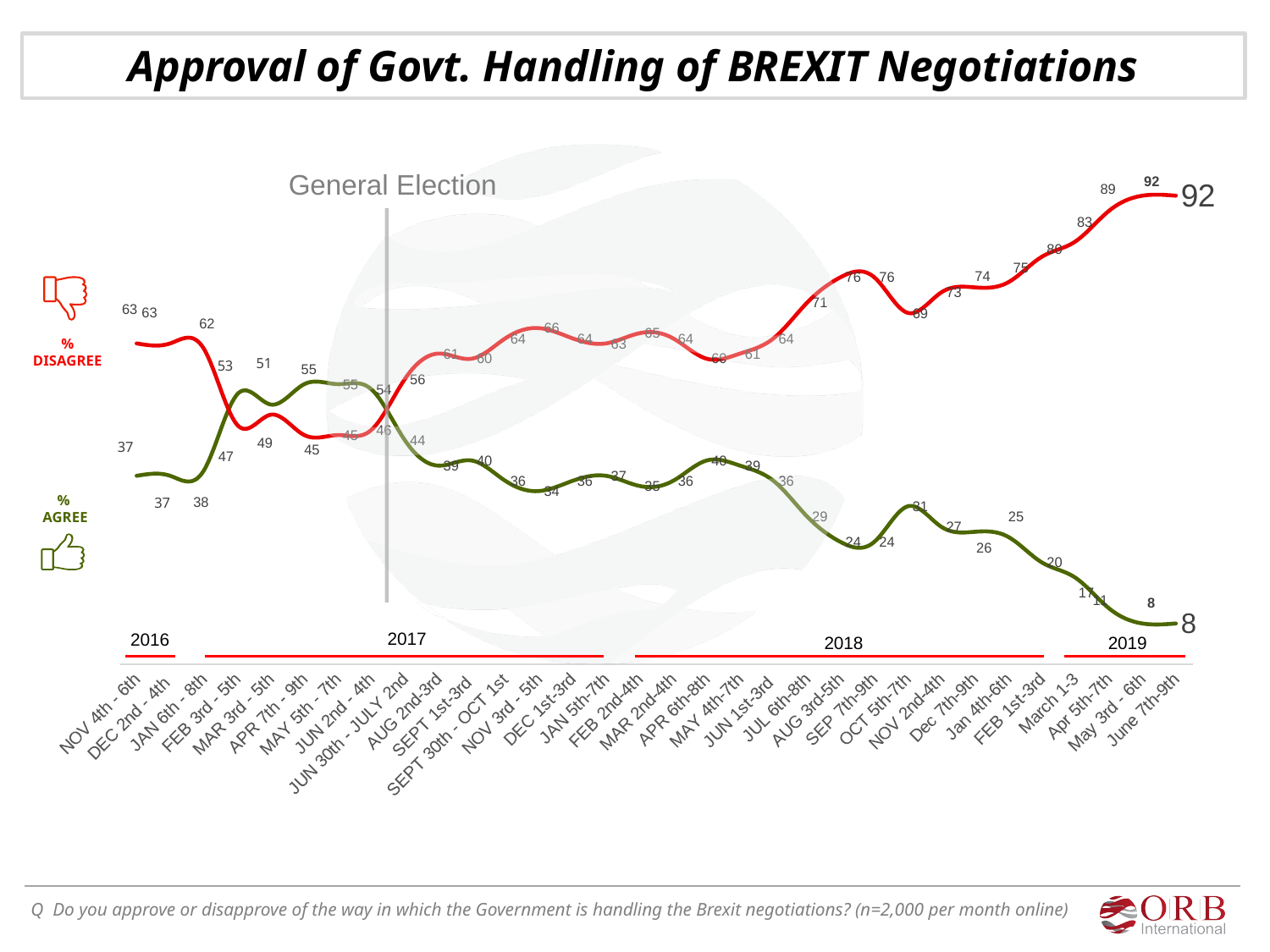
At the final point, what is the difference between % DISAGREE and % AGREE? 84 What is the % AGREE value at the first point (NOV 4th-6th 2016)? 37 At the final point, which is larger: % DISAGREE or % AGREE? % DISAGREE What is the % DISAGREE value at the first point (NOV 4th-6th 2016)? 63 What is the % AGREE value at the final point (June 7th-9th 2019)? 8 How many series does the chart plot? 2 What is the highest value reached by the % DISAGREE line? 92 What is the lowest value reached by the % AGREE line? 8 Over the whole period, does the % DISAGREE line rise or fall overall? rise What kind of chart is shown on the slide? line chart What event is marked by the vertical grey line on the chart? General Election What is the % DISAGREE value at the final point (June 7th-9th 2019)? 92